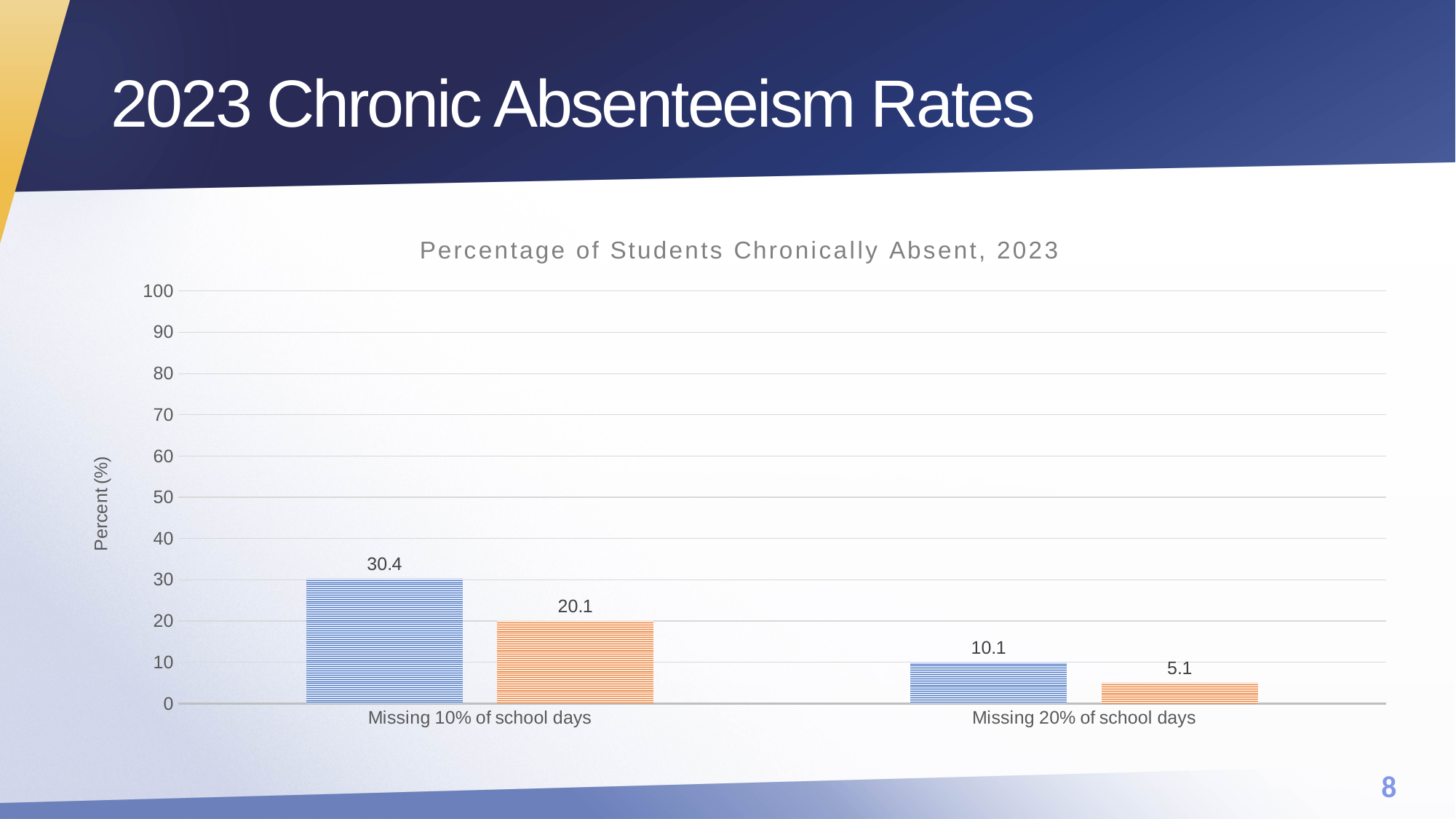
What is the difference between the blue bar values for "Missing 10% of school days" and "Missing 20% of school days"? 20.3 What is the value of the blue bar for "Missing 20% of school days"? 10.1 How many categories are shown on the x axis? 2 What is the difference between the blue and orange bars for "Missing 10% of school days"? 10.3 What is the value of the orange bar for "Missing 10% of school days"? 20.1 Which bar has the lowest value on the chart? Orange bar for Missing 20% of school days (5.1) What is the value of the orange bar for "Missing 20% of school days"? 5.1 Which is larger: the orange bar for "Missing 10% of school days" or the blue bar for "Missing 20% of school days"? Orange bar for Missing 10% of school days Is the blue bar for "Missing 10% of school days" greater or less than 30? greater What is the title of the chart? Percentage of Students Chronically Absent, 2023 What is the value of the blue bar for "Missing 10% of school days"? 30.4 Which bar has the highest value on the chart? Blue bar for Missing 10% of school days (30.4)